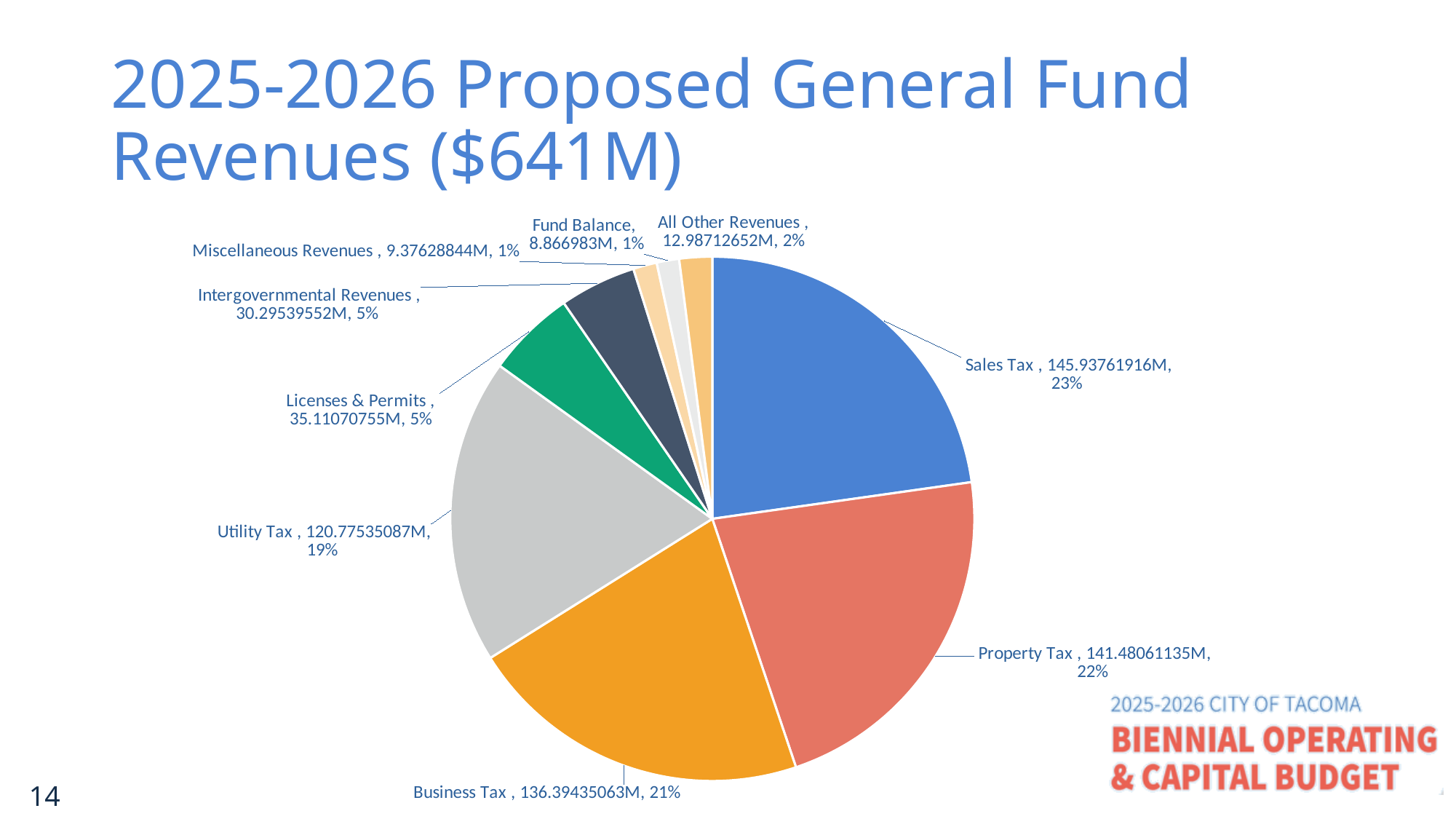
Which category has the smallest slice of the pie? Fund Balance What share of the pie does Business Tax represent? 21% What is the title of the slide containing the chart? 2025-2026 Proposed General Fund Revenues ($641M) What share of the pie does Licenses & Permits represent? 5% What kind of chart is shown on the slide? Pie chart What is the value shown for Intergovernmental Revenues? 30.29539552M What is the value shown for Utility Tax? 120.77535087M How many slices does the pie chart have? 9 Which category has the largest slice of the pie? Sales Tax Which is larger, Property Tax or Business Tax? Property Tax What is the difference in percentage share between Sales Tax and Utility Tax? 4 percentage points What is the value shown for Sales Tax? 145.93761916M